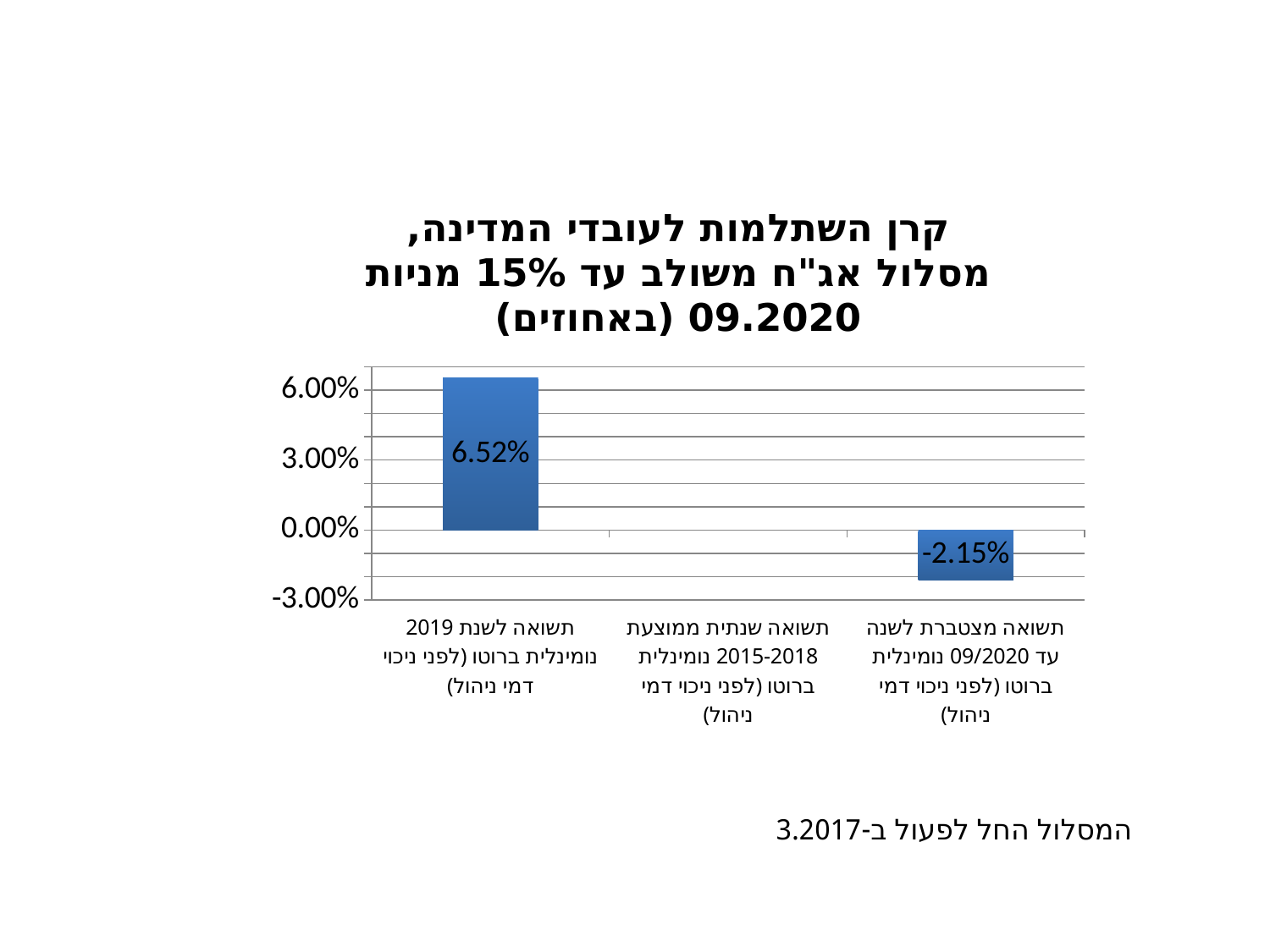
What is the value for the cumulative return for the year to 09/2020 (תשואה מצטברת לשנה עד 09/2020)? -2.15% Which category has the highest value? תשואה לשנת 2019 נומינלית ברוטו (לפני ניכוי דמי ניהול) What is the lowest value shown on the y axis? -3.00% Which is larger: the 2019 return or the cumulative return to 09/2020? The 2019 return Which category with a plotted bar has the lowest value? תשואה מצטברת לשנה עד 09/2020 נומינלית ברוטו (לפני ניכוי דמי ניהול) What kind of chart is shown on the slide? Bar chart Is the value for the 2019 return greater or less than 6.00%? greater How many categories are shown on the x axis? 3 What is the difference between the 2019 return (6.52%) and the cumulative return to 09/2020 (-2.15%)? 8.67 percentage points Which category on the x axis has no bar plotted? תשואה שנתית ממוצעת 2015-2018 נומינלית ברוטו (לפני ניכוי דמי ניהול) Is the value for the cumulative return to 09/2020 greater or less than 0.00%? less What is the value for the 2019 nominal gross return (תשואה לשנת 2019 נומינלית ברוטו)? 6.52%